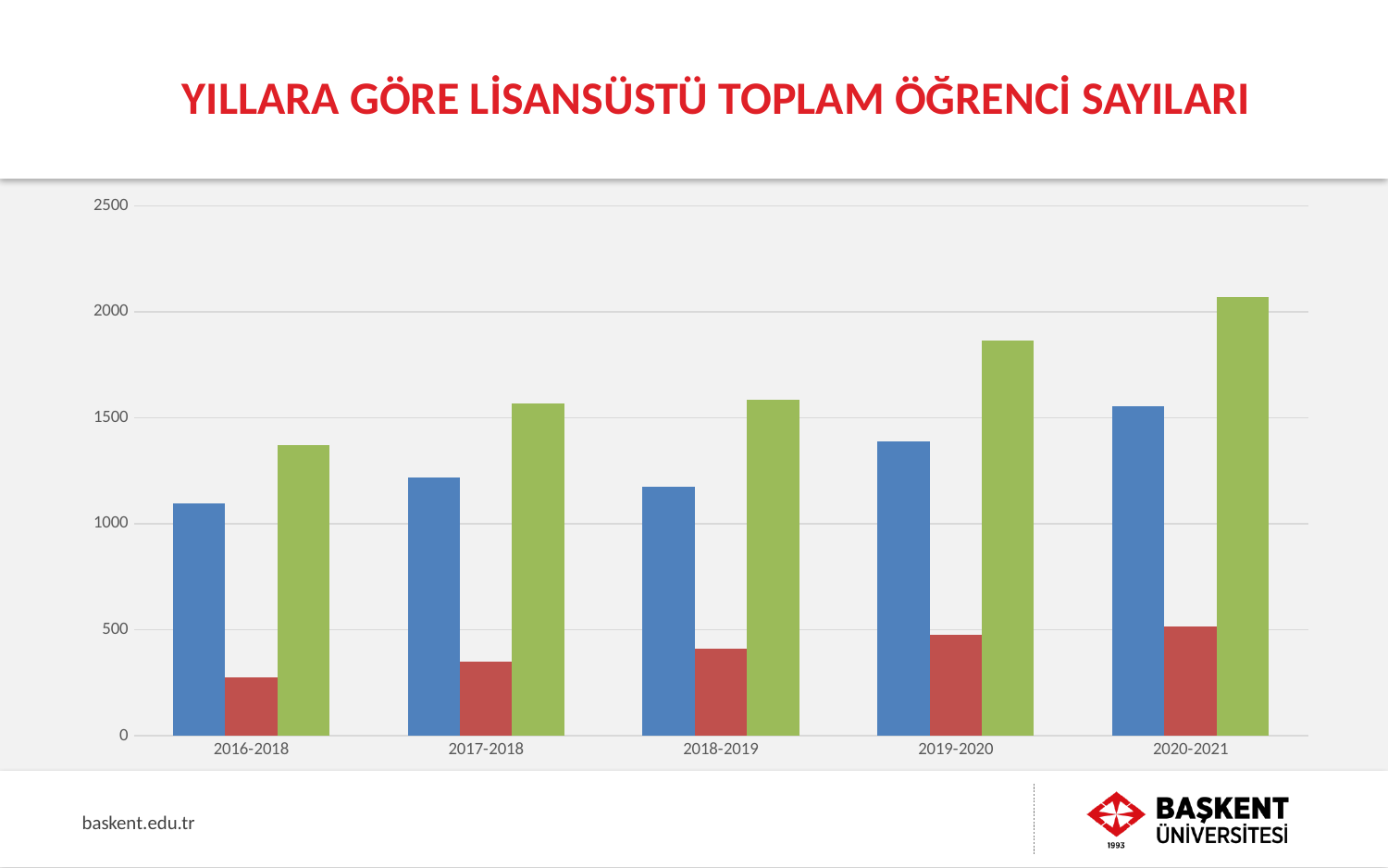
Is the value of the green bar for 2016-2018 greater or less than 1500? less How many year categories are shown on the x axis? 5 What is the title of the chart? YILLARA GÖRE LİSANSÜSTÜ TOPLAM ÖĞRENCİ SAYILARI Do the green bars generally rise or fall from 2016-2018 to 2020-2021? rise How many bars are shown for each year category? 3 What kind of chart is shown on the slide? bar chart Is the value of the red bar for 2016-2018 greater or less than 500? less For 2020-2021, which is larger, the green bar or the blue bar? green bar Is the value of the blue bar for 2020-2021 greater or less than 1500? greater In which year category is the red bar lowest? 2016-2018 In which year category is the green bar highest? 2020-2021